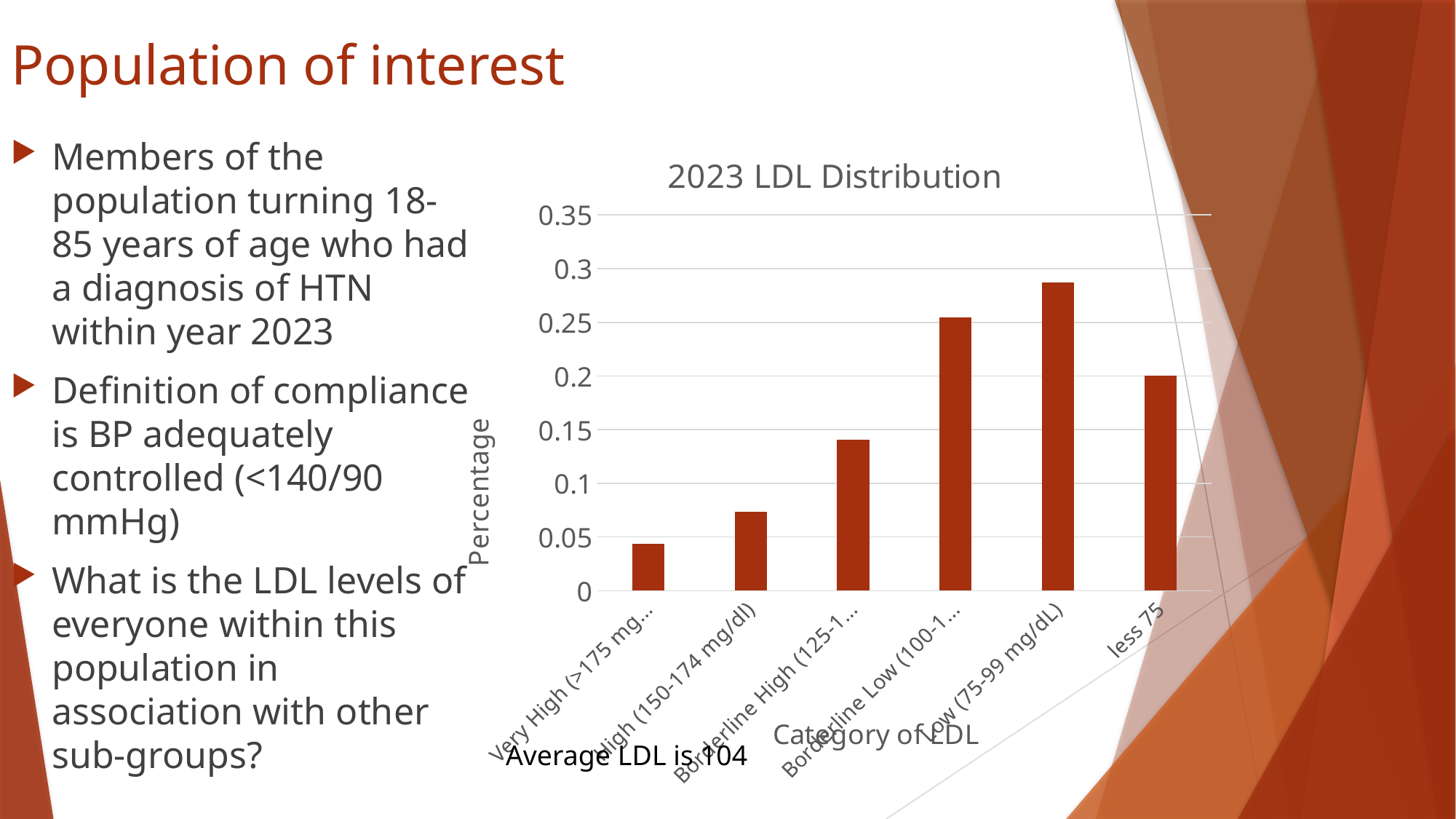
Is the value for Low (75-99 mg/dL) greater or less than 0.25? greater Which has a higher percentage, Low (75-99 mg/dL) or less 75? Low (75-99 mg/dL) How many LDL categories are shown on the x axis of the 2023 LDL Distribution chart? 6 Is the value for Borderline Low greater or less than 0.2? greater Is the value for less 75 greater or less than 0.25? less Which LDL category has the highest percentage in the 2023 LDL Distribution chart? Low (75-99 mg/dL) What is the title of the chart on the slide? 2023 LDL Distribution What kind of chart is the 2023 LDL Distribution chart? bar chart Which LDL category has the lowest percentage in the 2023 LDL Distribution chart? Very High (>175 mg...) Which has a higher percentage, Borderline High or Borderline Low? Borderline Low